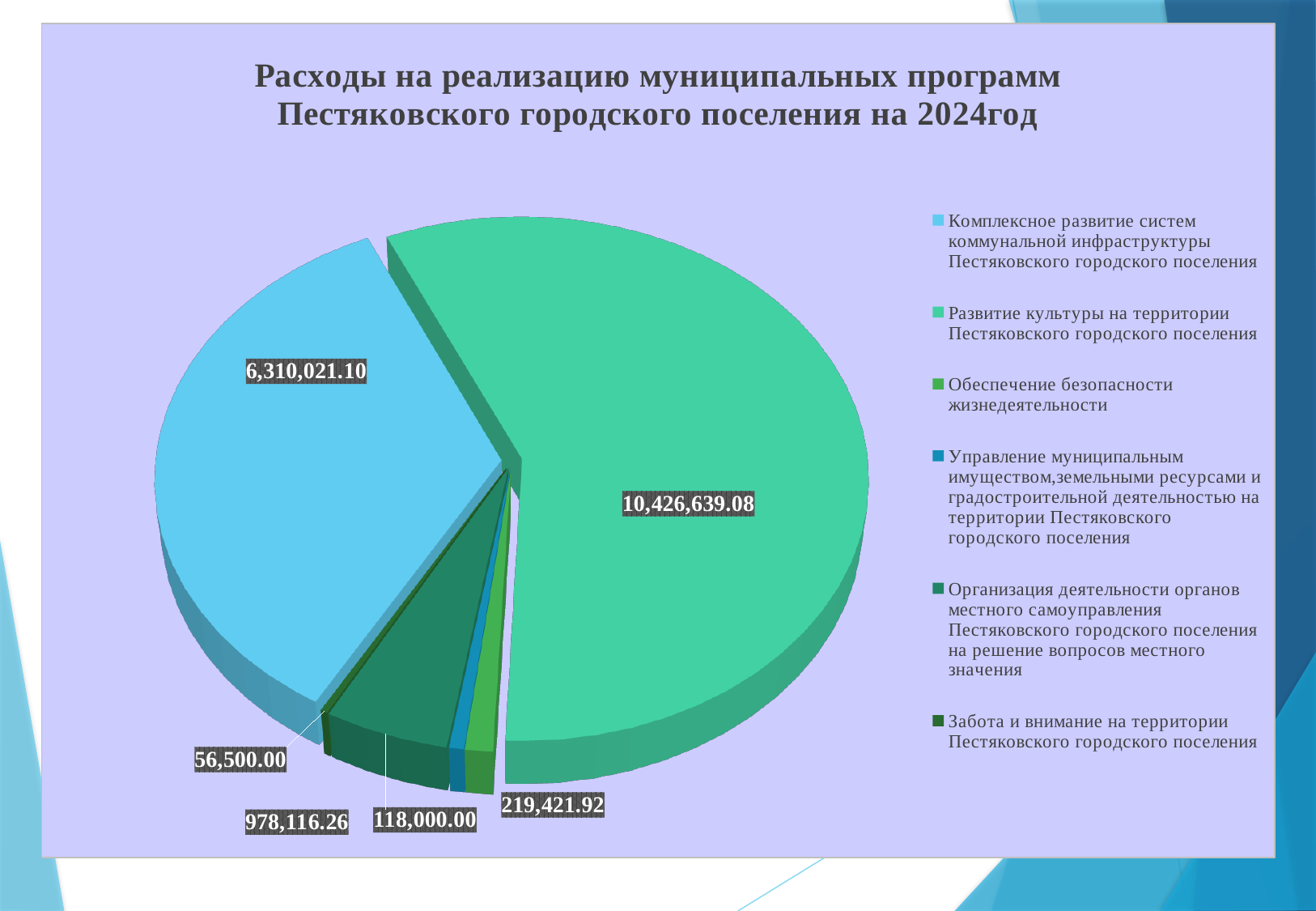
What is the value for "Организация деятельности органов местного самоуправления Пестяковского городского поселения на решение вопросов местного значения"? 978,116.26 Which is larger: the value for "Управление муниципальным имуществом" or the value for "Забота и внимание"? Управление муниципальным имуществом What is the value for "Развитие культуры на территории Пестяковского городского поселения"? 10,426,639.08 Which category has the largest slice of the pie? Развитие культуры на территории Пестяковского городского поселения What kind of chart is shown on the slide? pie chart How many categories does the legend list? 6 Which category has the smallest slice of the pie? Забота и внимание на территории Пестяковского городского поселения What is the difference between the values for "Развитие культуры" and "Комплексное развитие систем коммунальной инфраструктуры"? 4,116,617.98 What is the value for "Забота и внимание на территории Пестяковского городского поселения"? 56,500.00 What is the title of the chart? Расходы на реализацию муниципальных программ Пестяковского городского поселения на 2024год What is the difference between the values for "Обеспечение безопасности жизнедеятельности" and "Управление муниципальным имуществом, земельными ресурсами и градостроительной деятельностью"? 101,421.92 What is the value for "Комплексное развитие систем коммунальной инфраструктуры Пестяковского городского поселения"? 6,310,021.10